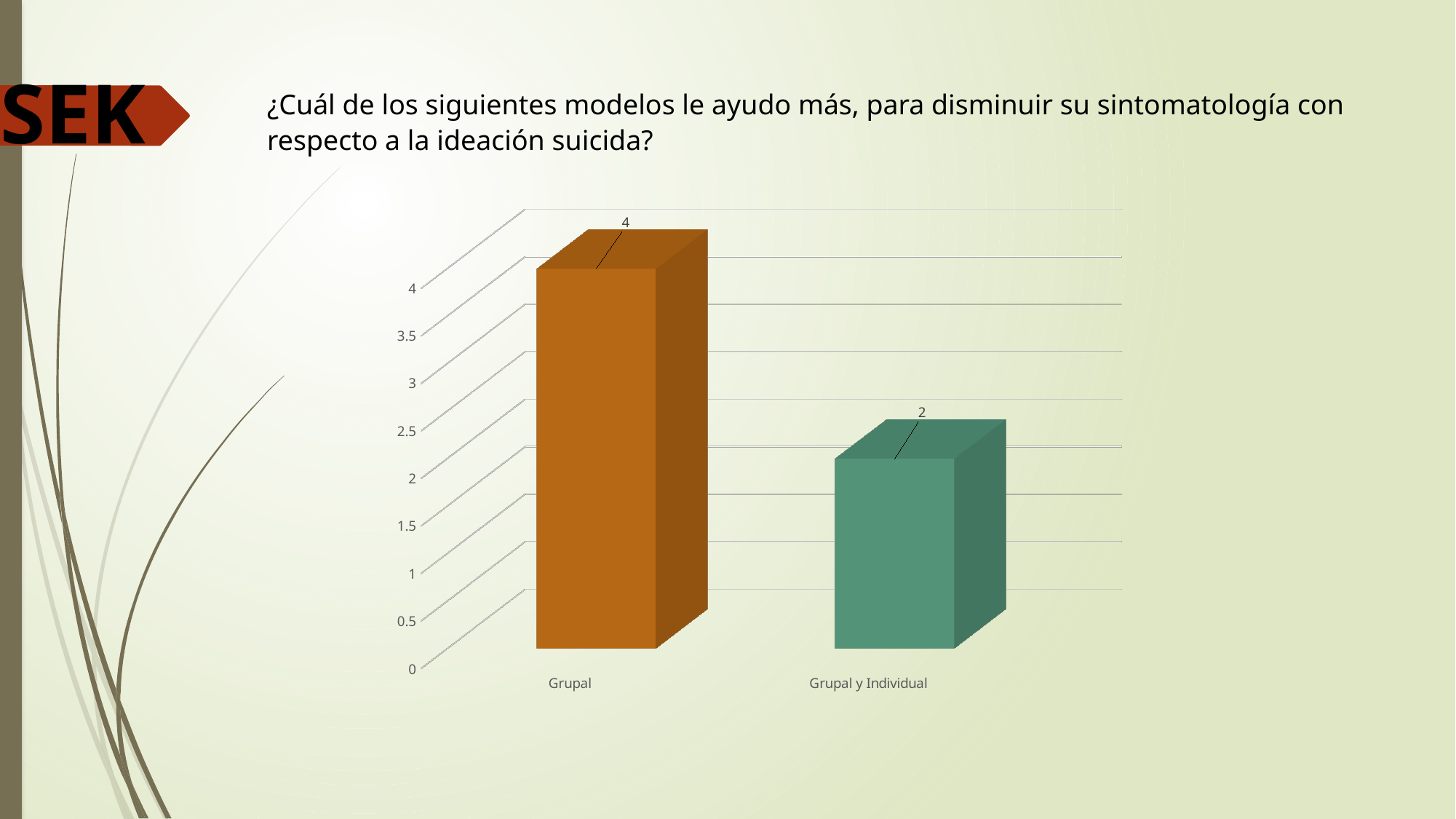
What is the highest value shown on the vertical axis? 4 Is the value for Grupal y Individual greater or less than 3? less Which category has the highest value? Grupal What kind of chart is shown on the slide? bar chart What is the value for Grupal? 4 Which category has the lowest value? Grupal y Individual What is the difference between the values for Grupal and Grupal y Individual? 2 What is the total of the values for Grupal and Grupal y Individual? 6 How many categories are shown on the chart? 2 What colour is the bar for Grupal? orange What is the value for Grupal y Individual? 2 Which is larger, the value for Grupal or the value for Grupal y Individual? Grupal